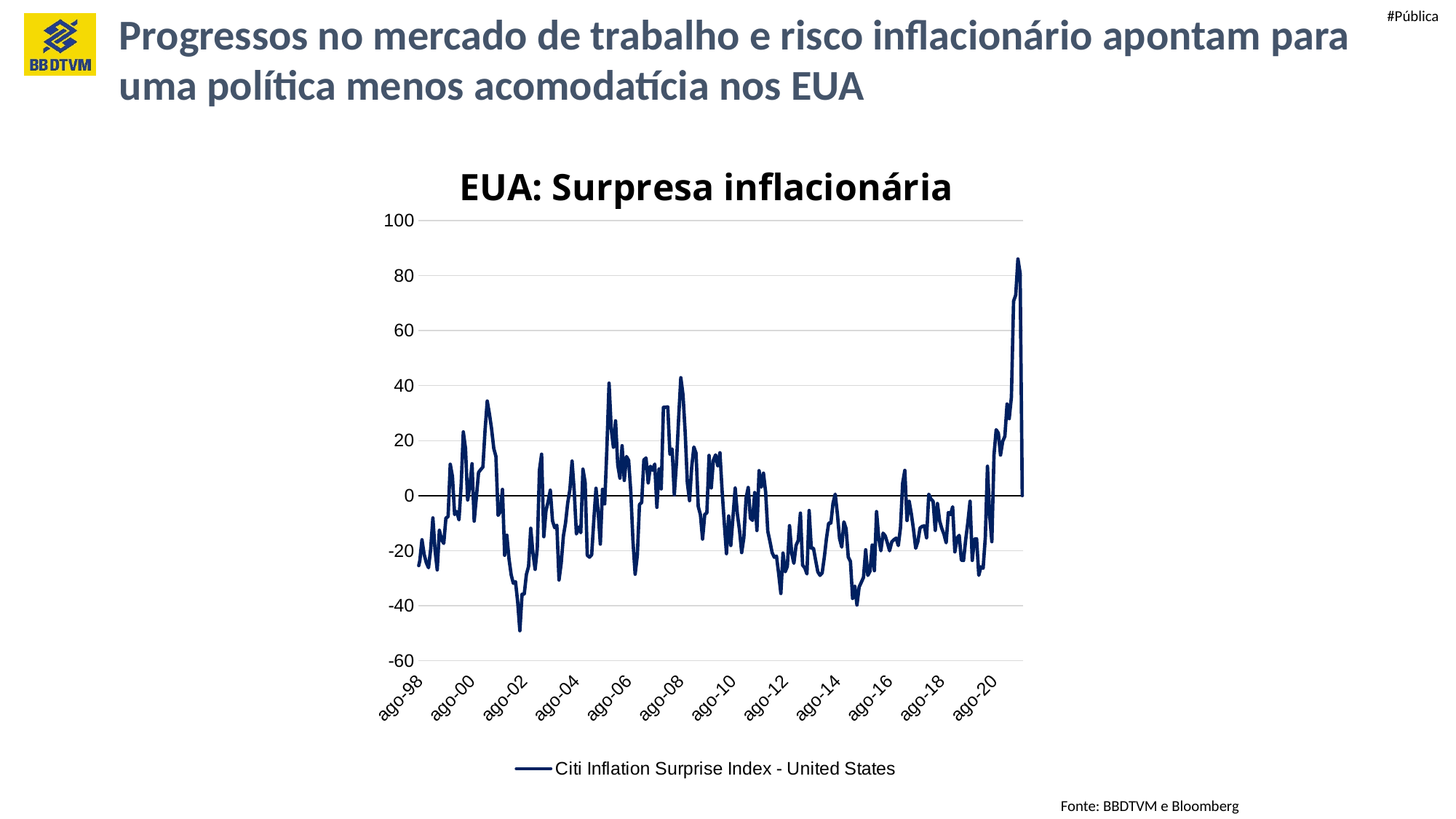
How many series does the legend list? 1 What kind of chart is shown on the slide? line chart How many date labels are shown on the x axis? 12 Is the lowest point of the series closer to ago-02 or to ago-20? ago-02 Is the lowest value reached by the Citi Inflation Surprise Index greater or less than -40? less What series name is shown in the legend? Citi Inflation Surprise Index - United States From ago-18 to the end of the series, does the Citi Inflation Surprise Index rise or fall? rise What is the title of the chart? EUA: Surpresa inflacionária Is the peak of the series reached near the start or near the end of the period shown? near the end Which is larger: the value of the series at its peak near ago-20 or its peak near ago-08? the peak near ago-20 Is the highest value reached by the Citi Inflation Surprise Index greater or less than 80? greater Is the value of the Citi Inflation Surprise Index at ago-98 greater or less than 0? less